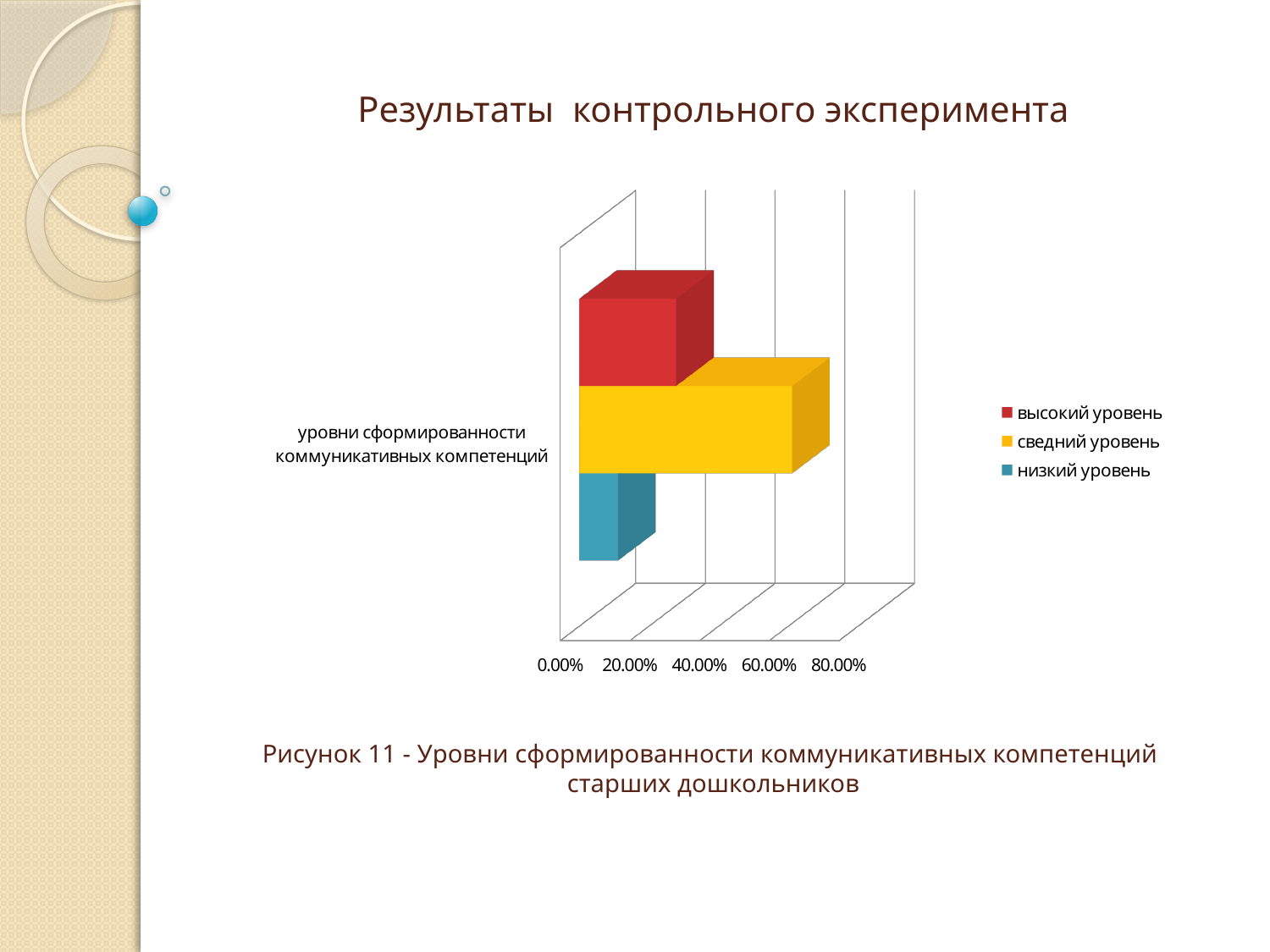
Which series has the highest value? сведний уровень What kind of chart is shown on the slide? bar chart Is the value for высокий уровень greater or less than 40.00%? less How many categories are plotted on the chart? 1 Is the value for низкий уровень greater or less than 40.00%? less What colour represents высокий уровень in the chart? red Which is larger, the value for сведний уровень or the value for высокий уровень? сведний уровень Is the value for сведний уровень greater or less than 40.00%? greater How many series does the legend list? 3 Which series has the lowest value? низкий уровень Which is larger, the value for высокий уровень or the value for низкий уровень? высокий уровень